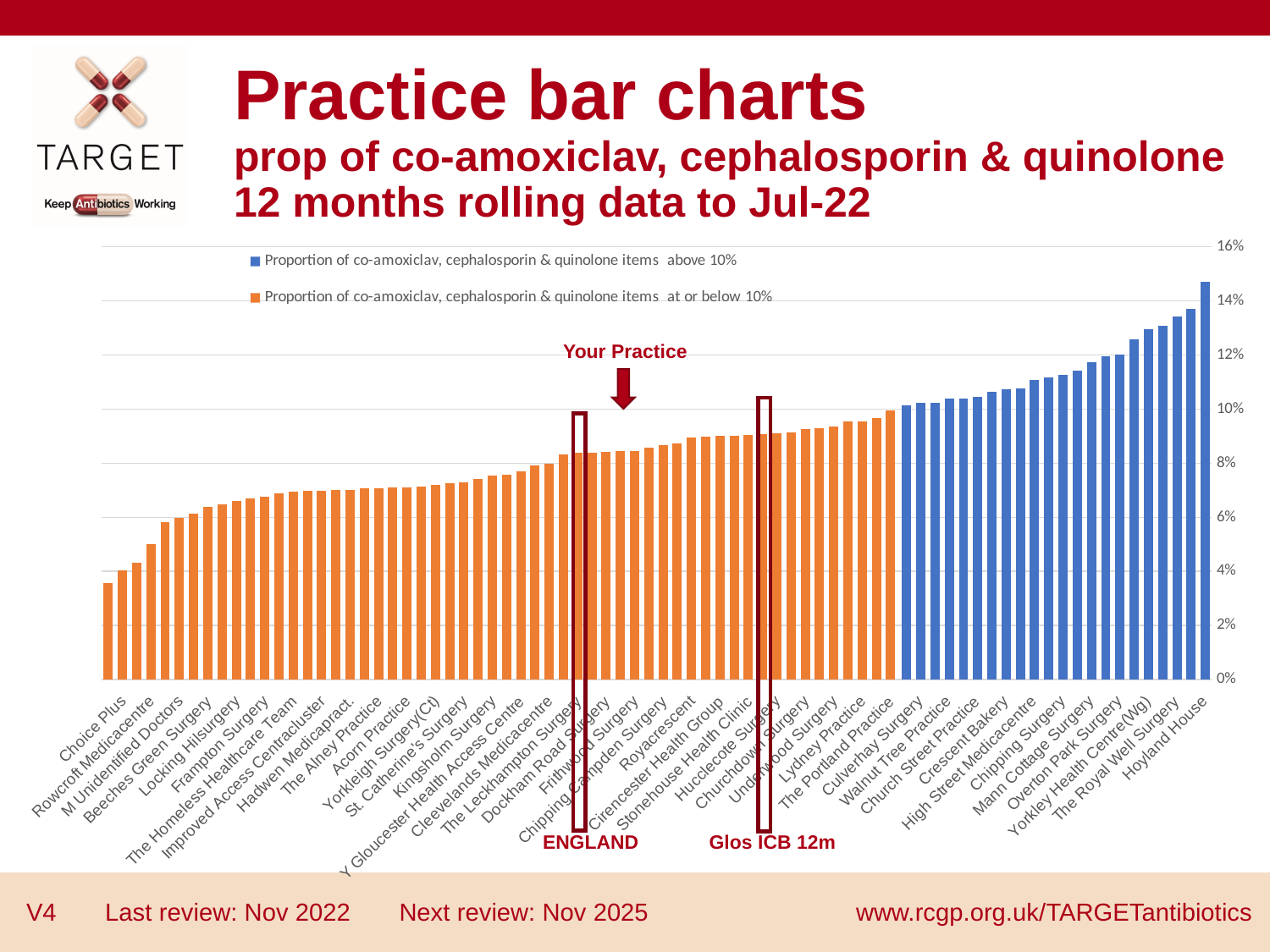
Which practice has the highest proportion of co-amoxiclav, cephalosporin & quinolone items? Hoyland House Is the value for Hoyland House greater or less than 14%? greater How many series does the legend list? 2 Is the value for Rowcroft Medicacentre greater or less than 6%? less Is the value for Frampton Surgery greater or less than 6%? greater What kind of chart is shown on the slide? bar chart Do the bar values rise or fall from left to right along the x axis? rise Which two benchmark bars are outlined in red boxes on the chart? ENGLAND and Glos ICB 12m What colour are the bars for practices with a proportion above 10%? blue Which has a larger value, Hoyland House or Choice Plus? Hoyland House